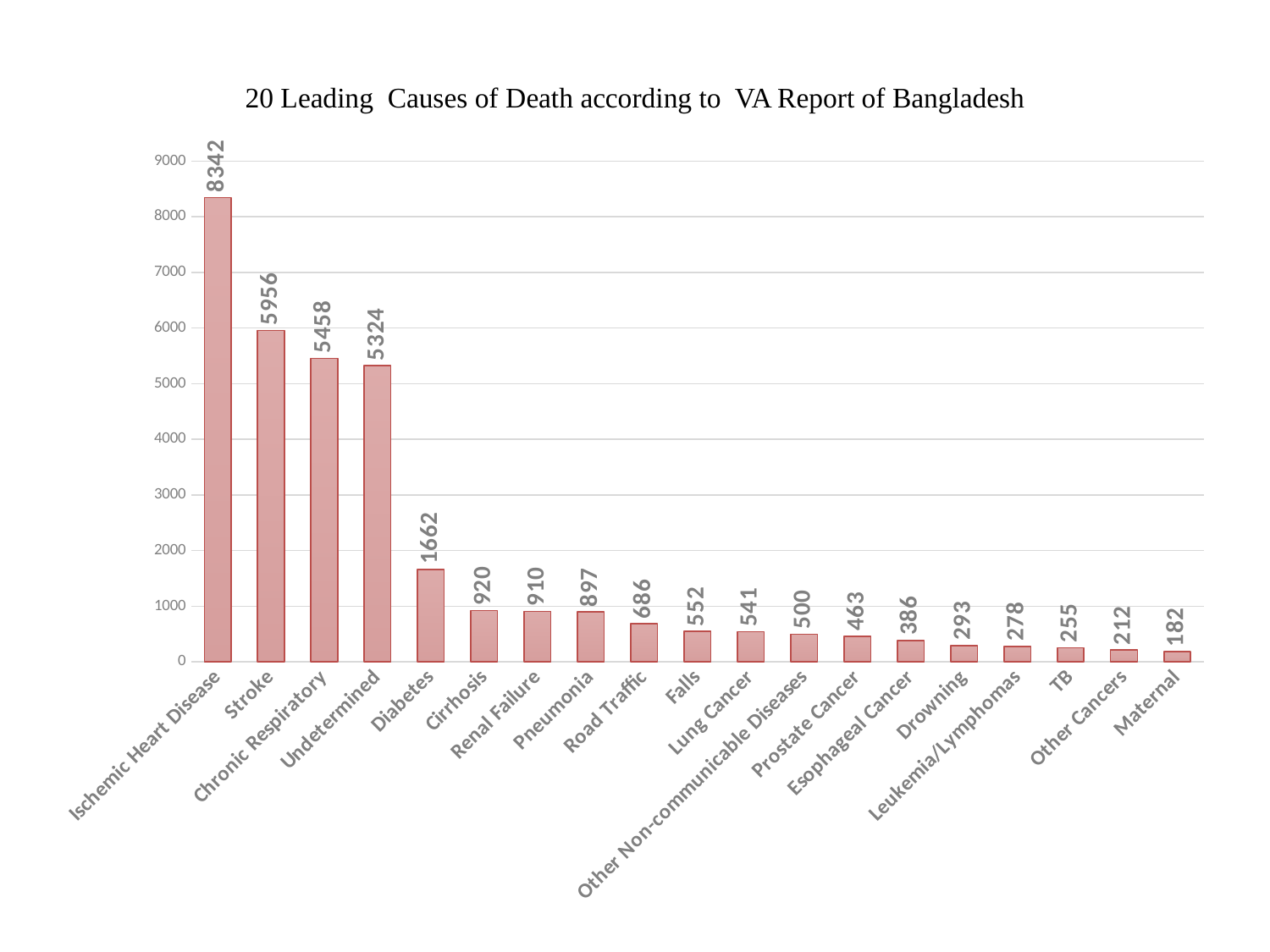
What is the difference between the values for Chronic Respiratory and Undetermined? 134 Is the value for Diabetes greater or less than 2000? less What is the title of the chart? 20 Leading Causes of Death according to VA Report of Bangladesh What is the value for Stroke? 5956 Which cause of death has the lowest value? Maternal What is the value for Diabetes? 1662 What kind of chart is shown on the slide? bar chart Which is larger, the value for Pneumonia or the value for Road Traffic? Pneumonia What is the value for Drowning? 293 How many causes of death are shown on the chart? 19 Which cause of death has the highest value? Ischemic Heart Disease What is the difference between the values for Ischemic Heart Disease and Stroke? 2386